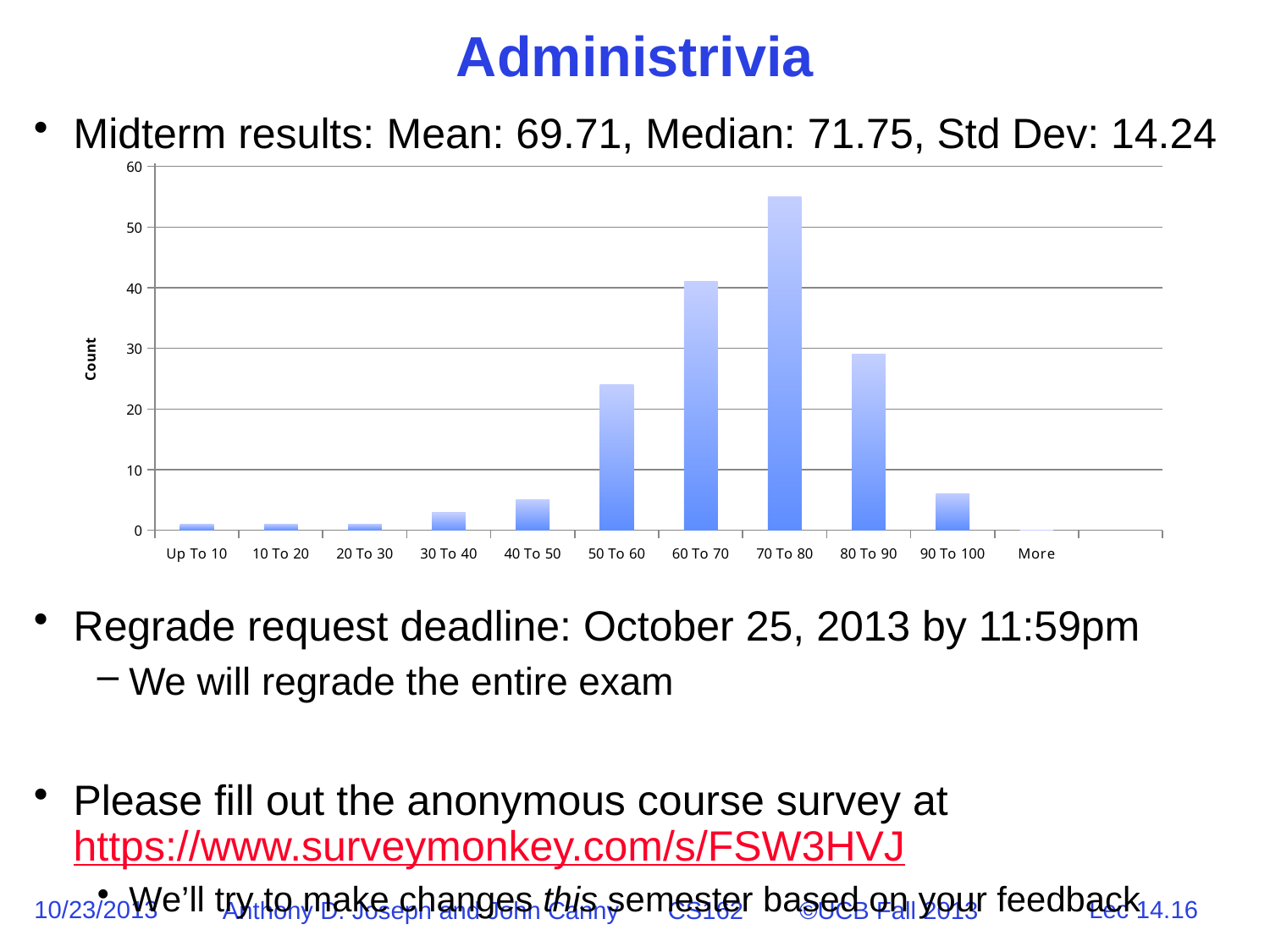
Is the count for 70 To 80 greater or less than 50? greater Which has a higher count, 60 To 70 or 80 To 90? 60 To 70 Which score range has the highest count in the chart? 70 To 80 What is the highest value shown on the vertical axis of the chart? 60 How many score ranges (categories) are shown on the x axis of the chart? 11 Is the count for 90 To 100 greater or less than 10? less Is the count for 50 To 60 greater or less than 20? greater What is the label on the vertical axis of the chart? Count Which has a higher count, 50 To 60 or 40 To 50? 50 To 60 What kind of chart is shown on the slide? bar chart